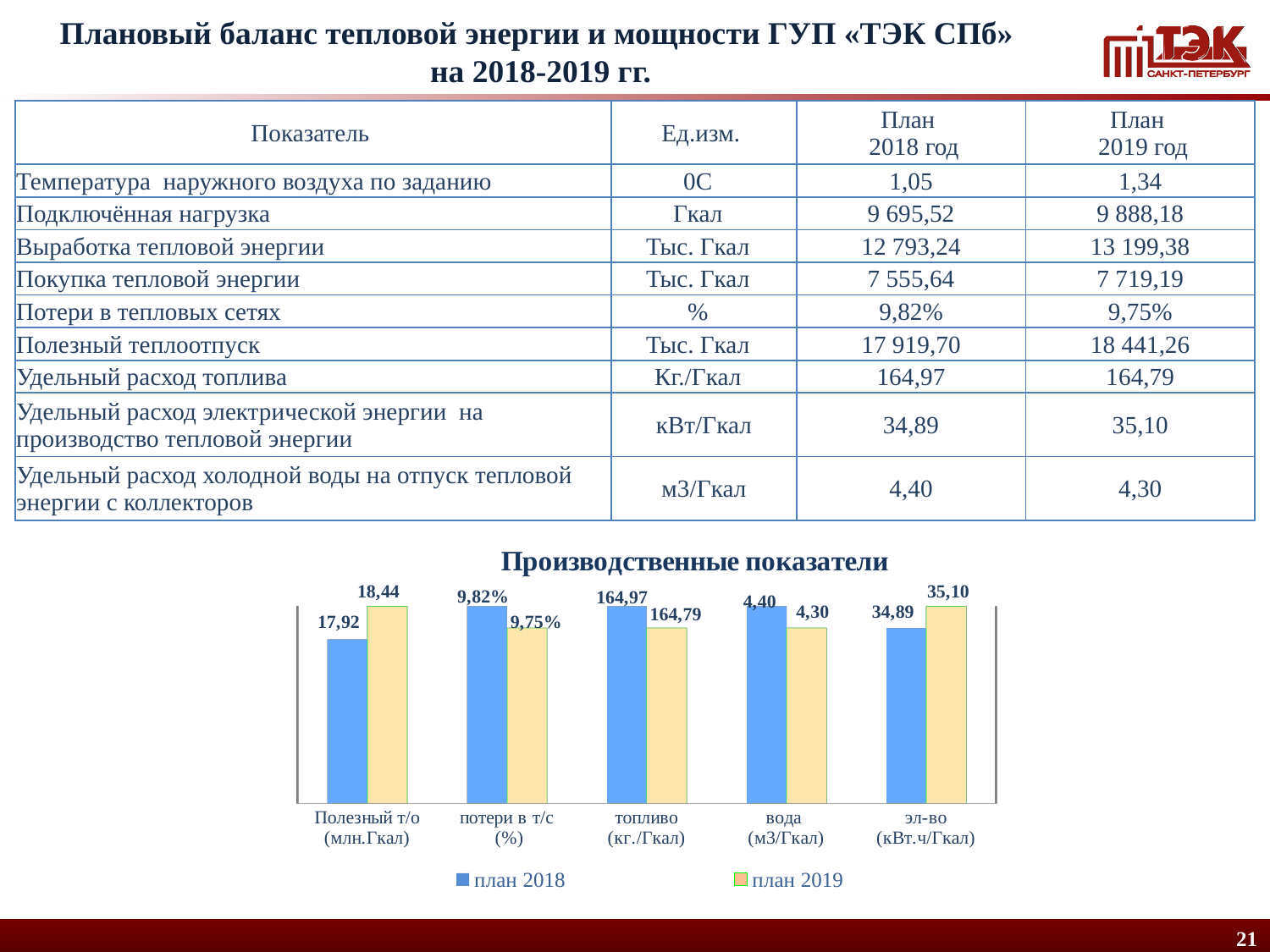
In the «Производственные показатели» chart, which series has the larger value for «вода (м3/Гкал)», «план 2018» or «план 2019»? план 2018 What kind of chart is shown under the title «Производственные показатели»? bar chart In the «Производственные показатели» chart, what is the «план 2018» value for «топливо (кг./Гкал)»? 164,97 How many series does the legend of the «Производственные показатели» chart list? 2 How many categories are shown on the x axis of the «Производственные показатели» chart? 5 In the «Производственные показатели» chart, what is the difference between the «план 2019» and «план 2018» values for «Полезный т/о (млн.Гкал)»? 0,52 In the «Производственные показатели» chart, what is the value of «план 2019» for «Полезный т/о (млн.Гкал)»? 18,44 What are the two legend entries of the «Производственные показатели» chart? план 2018, план 2019 In the «Производственные показатели» chart, what is the «план 2019» value for «эл-во (кВт.ч/Гкал)»? 35,10 In the «Производственные показатели» chart, which series has the larger value for «эл-во (кВт.ч/Гкал)», «план 2018» or «план 2019»? план 2019 In the «Производственные показатели» chart, what is the value of «план 2018» for «Полезный т/о (млн.Гкал)»? 17,92 In the «Производственные показатели» chart, what is the «план 2019» value for «потери в т/с (%)»? 9,75%